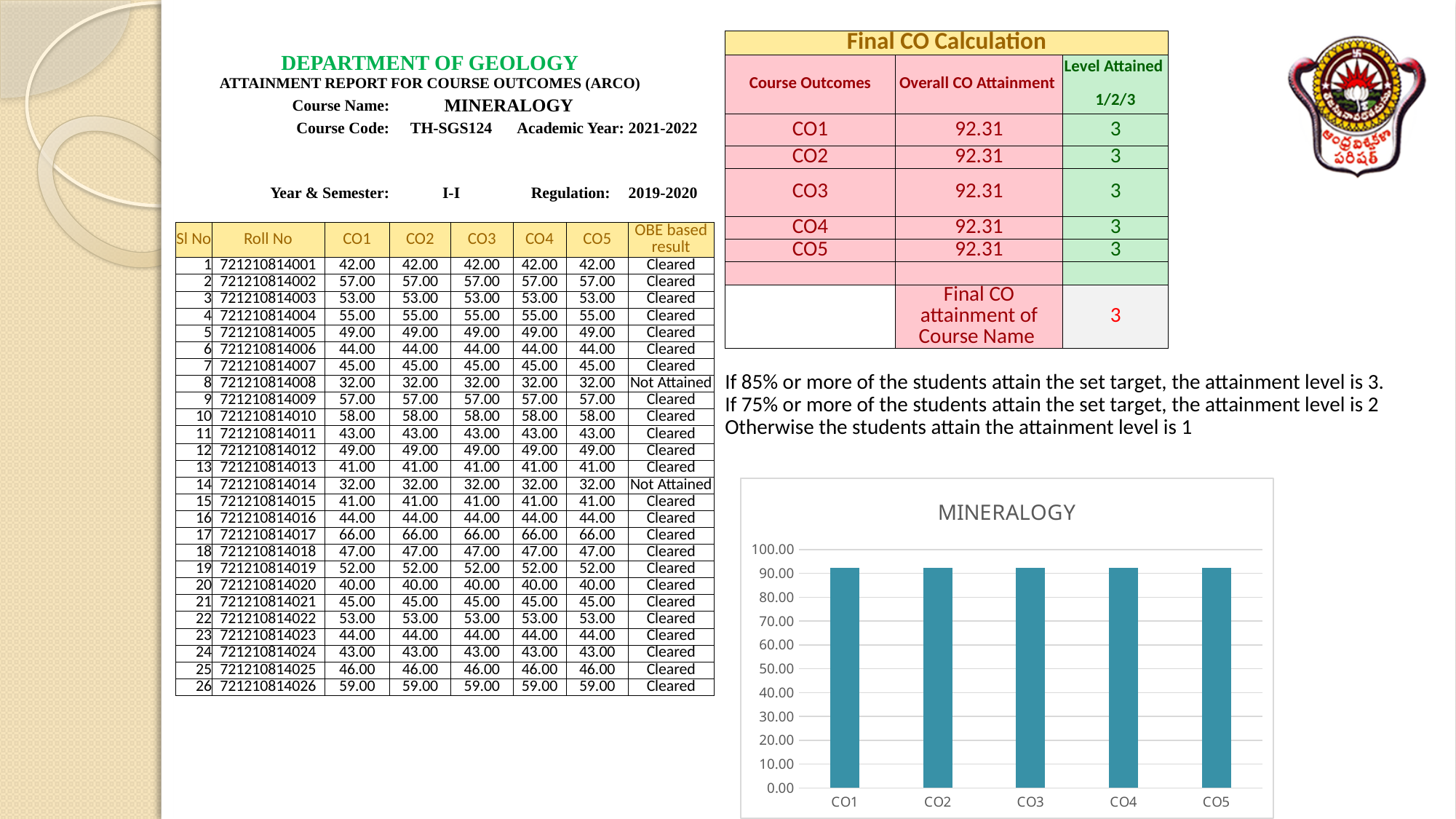
What kind of chart is shown on the slide? bar chart Is the value for CO2 in the chart greater or less than 70.00? greater What is the label of the last category on the x axis of the chart? CO5 Do the bar values rise, fall, or stay the same from CO1 to CO5? stay the same What is the title of the chart? MINERALOGY Is the value for CO5 in the chart greater or less than 50.00? greater What is the highest tick value shown on the y axis of the chart? 100.00 How many categories are plotted on the x axis of the chart? 5 Is the value for CO3 in the chart greater or less than 100.00? less What is the label of the first category on the x axis of the chart? CO1